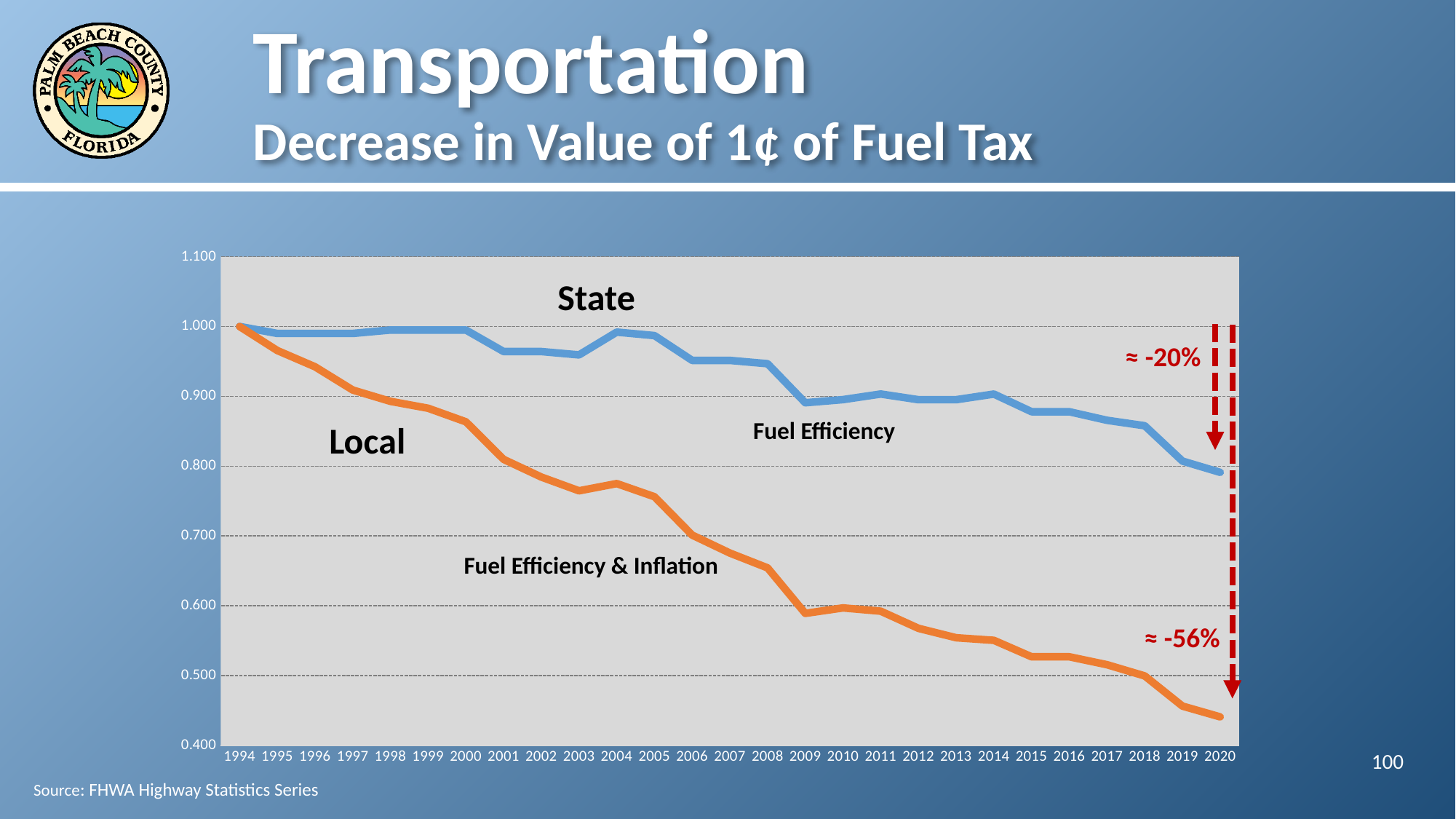
In 2010, which line has the higher value, State or Local? State How many years are shown along the x axis of the chart? 27 Is the value of the Local line in 2000 greater or less than 0.800? greater Is the value of the State line in 2006 greater or less than 0.900? greater What approximate percentage decrease is annotated for the Local line? ≈ -56% How many lines (series) are plotted on the chart? 2 Do the values of the Local line rise or fall from 1994 to 2020? fall What is the value of the State line in 1994? 1.000 What is the value of the Local line in 1994? 1.000 Is the value of the Local line in 2020 greater or less than 0.500? less What kind of chart is shown on the slide? line chart